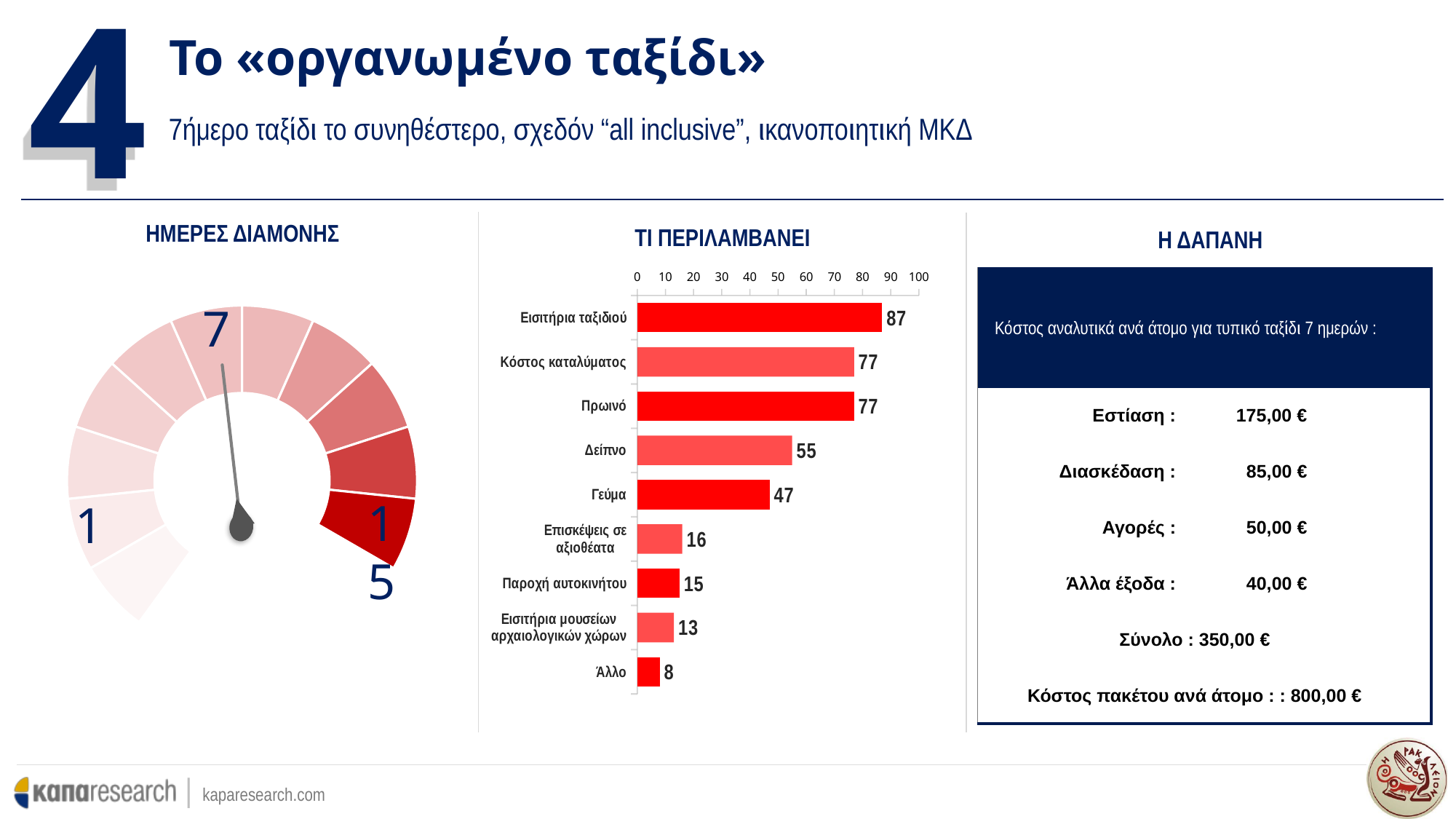
In the 'ΤΙ ΠΕΡΙΛΑΜΒΑΝΕΙ' chart, is the value for Πρωινό greater or less than 70? greater How many categories are shown in the 'ΤΙ ΠΕΡΙΛΑΜΒΑΝΕΙ' chart? 9 In the 'ΤΙ ΠΕΡΙΛΑΜΒΑΝΕΙ' chart, what is the value for Εισιτήρια ταξιδιού? 87 In the 'ΤΙ ΠΕΡΙΛΑΜΒΑΝΕΙ' chart, what is the difference between Εισιτήρια ταξιδιού and Κόστος καταλύματος? 10 In the 'ΤΙ ΠΕΡΙΛΑΜΒΑΝΕΙ' chart, which category has the highest value? Εισιτήρια ταξιδιού In the 'ΤΙ ΠΕΡΙΛΑΜΒΑΝΕΙ' chart, what is the value for Δείπνο? 55 What is the title of the gauge chart on the left of the slide? ΗΜΕΡΕΣ ΔΙΑΜΟΝΗΣ What kind of chart is the 'ΤΙ ΠΕΡΙΛΑΜΒΑΝΕΙ' chart? Bar chart In the 'ΤΙ ΠΕΡΙΛΑΜΒΑΝΕΙ' chart, what is the difference between Δείπνο and Γεύμα? 8 In the 'ΤΙ ΠΕΡΙΛΑΜΒΑΝΕΙ' chart, what is the value for Παροχή αυτοκινήτου? 15 In the 'ΤΙ ΠΕΡΙΛΑΜΒΑΝΕΙ' chart, which is larger: Γεύμα or Επισκέψεις σε αξιοθέατα? Γεύμα In the 'ΤΙ ΠΕΡΙΛΑΜΒΑΝΕΙ' chart, which category has the lowest value? Άλλο